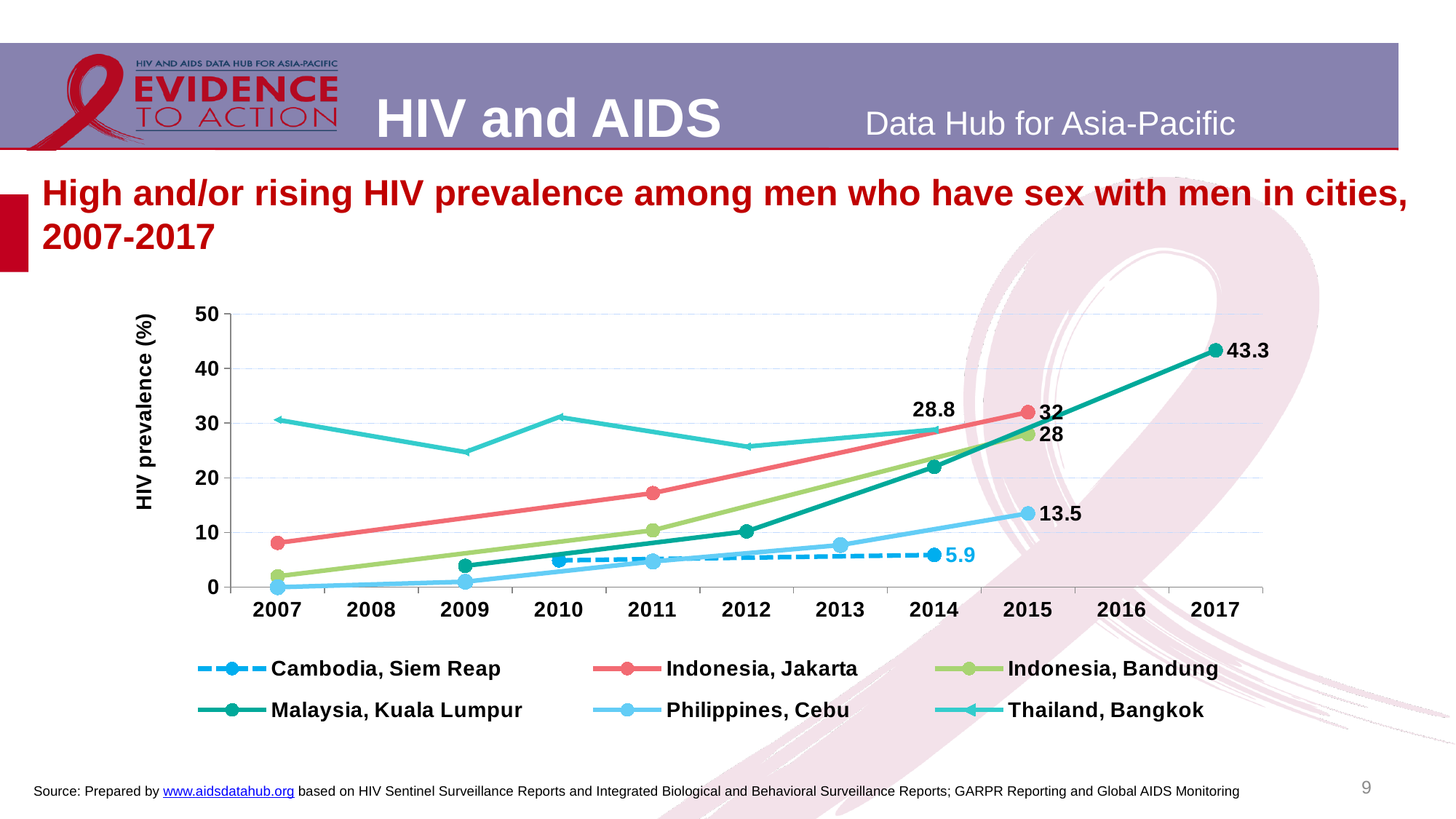
Does the HIV prevalence for Indonesia, Jakarta rise or fall from 2007 to 2015? Rise What is the HIV prevalence value labelled for Thailand, Bangkok in 2014? 28.8 In 2015, which has the larger HIV prevalence: Indonesia, Jakarta or Indonesia, Bandung? Indonesia, Jakarta Which city has the highest labelled HIV prevalence value on the chart? Malaysia, Kuala Lumpur Is the value for Thailand, Bangkok in 2009 greater or less than 30? less How many series does the legend list? 6 What is the HIV prevalence value labelled for Malaysia, Kuala Lumpur in 2017? 43.3 What kind of chart is shown on the slide? Line chart What is the difference between the 2015 values for Indonesia, Jakarta and Indonesia, Bandung? 4 What is the HIV prevalence value labelled for Philippines, Cebu in 2015? 13.5 What is the HIV prevalence value labelled for Cambodia, Siem Reap in 2014? 5.9 What is the HIV prevalence value labelled for Indonesia, Jakarta in 2015? 32